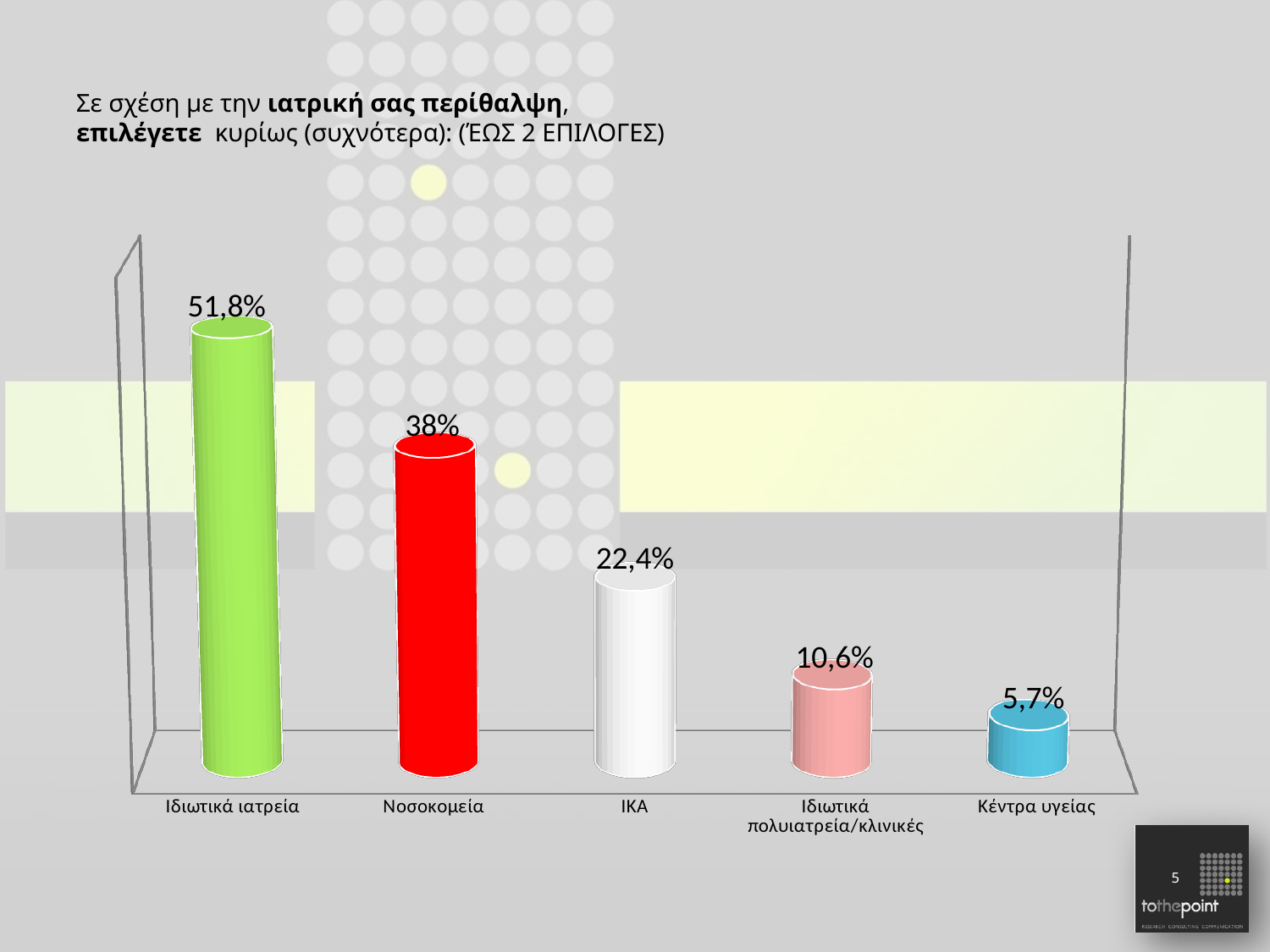
What is the difference between the values for Ιδιωτικά ιατρεία and Νοσοκομεία? 13,8% What is the value for Ιδιωτικά ιατρεία? 51,8% What is the value for Ιδιωτικά πολυιατρεία/κλινικές? 10,6% What is the value for ΙΚΑ? 22,4% Which category has the lowest value? Κέντρα υγείας What is the value for Κέντρα υγείας? 5,7% What is the value for Νοσοκομεία? 38% Do the values rise or fall from left to right across the categories? fall Which is larger, the value for Νοσοκομεία or the value for ΙΚΑ? Νοσοκομεία How many categories are shown in the chart? 5 What is the difference between the values for ΙΚΑ and Ιδιωτικά πολυιατρεία/κλινικές? 11,8% Which category has the highest value? Ιδιωτικά ιατρεία